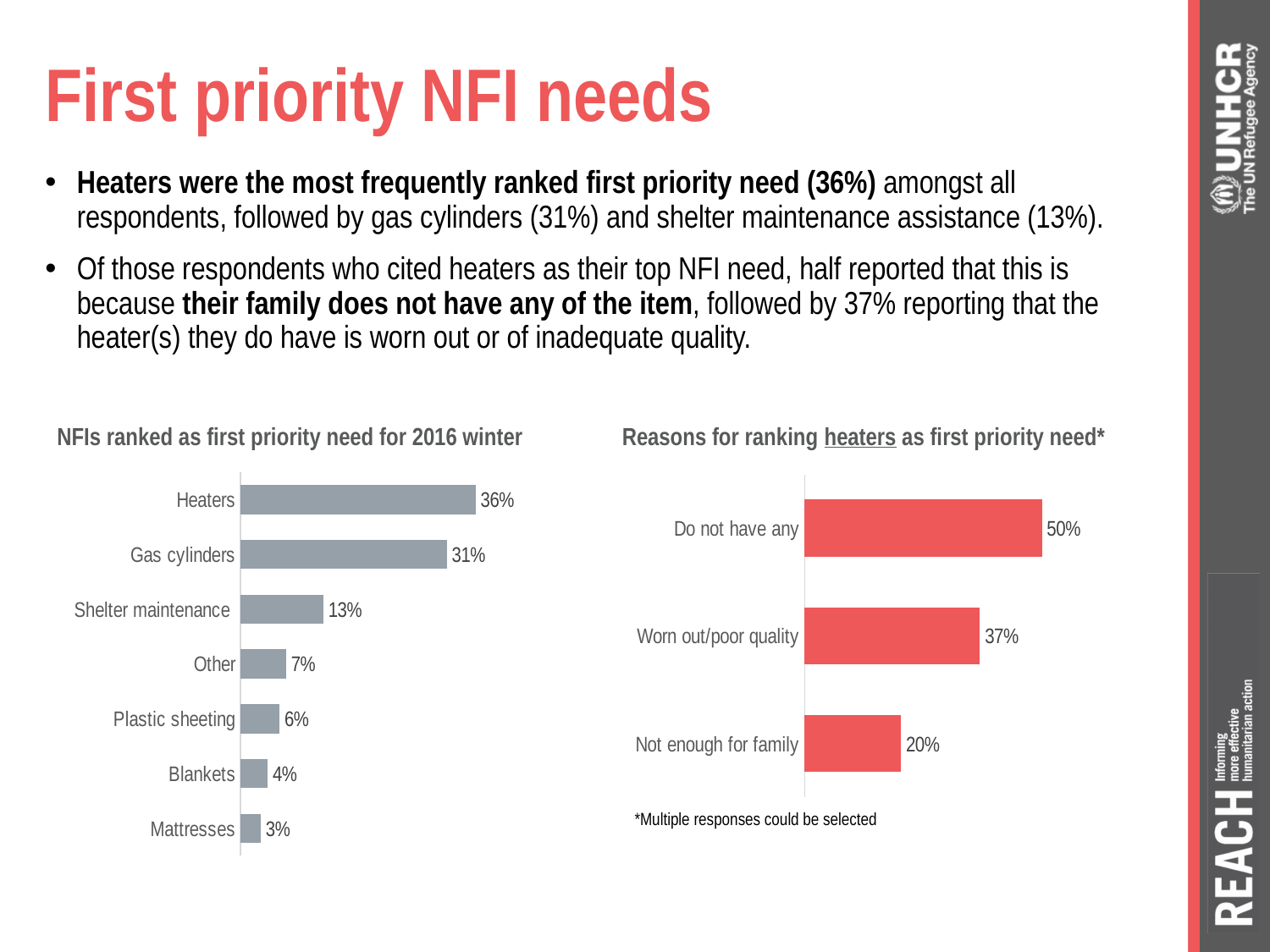
In the chart 'Reasons for ranking heaters as first priority need', what is the difference between the values for Do not have any and Not enough for family? 30% In the chart 'NFIs ranked as first priority need for 2016 winter', how many categories are shown? 7 In the chart 'NFIs ranked as first priority need for 2016 winter', what is the value for Gas cylinders? 31% In the chart 'NFIs ranked as first priority need for 2016 winter', which category has the highest value? Heaters In the chart 'NFIs ranked as first priority need for 2016 winter', which is larger, the value for Plastic sheeting or the value for Blankets? Plastic sheeting In the chart 'NFIs ranked as first priority need for 2016 winter', what is the difference between the values for Heaters and Shelter maintenance? 23% What type of chart is 'Reasons for ranking heaters as first priority need'? Bar chart In the chart 'Reasons for ranking heaters as first priority need', what is the value for Worn out/poor quality? 37% In the chart 'NFIs ranked as first priority need for 2016 winter', which category has the lowest value? Mattresses In the chart 'NFIs ranked as first priority need for 2016 winter', what is the value for Other? 7% In the chart 'Reasons for ranking heaters as first priority need', which reason has the highest value? Do not have any In the chart 'Reasons for ranking heaters as first priority need', how many categories are shown? 3